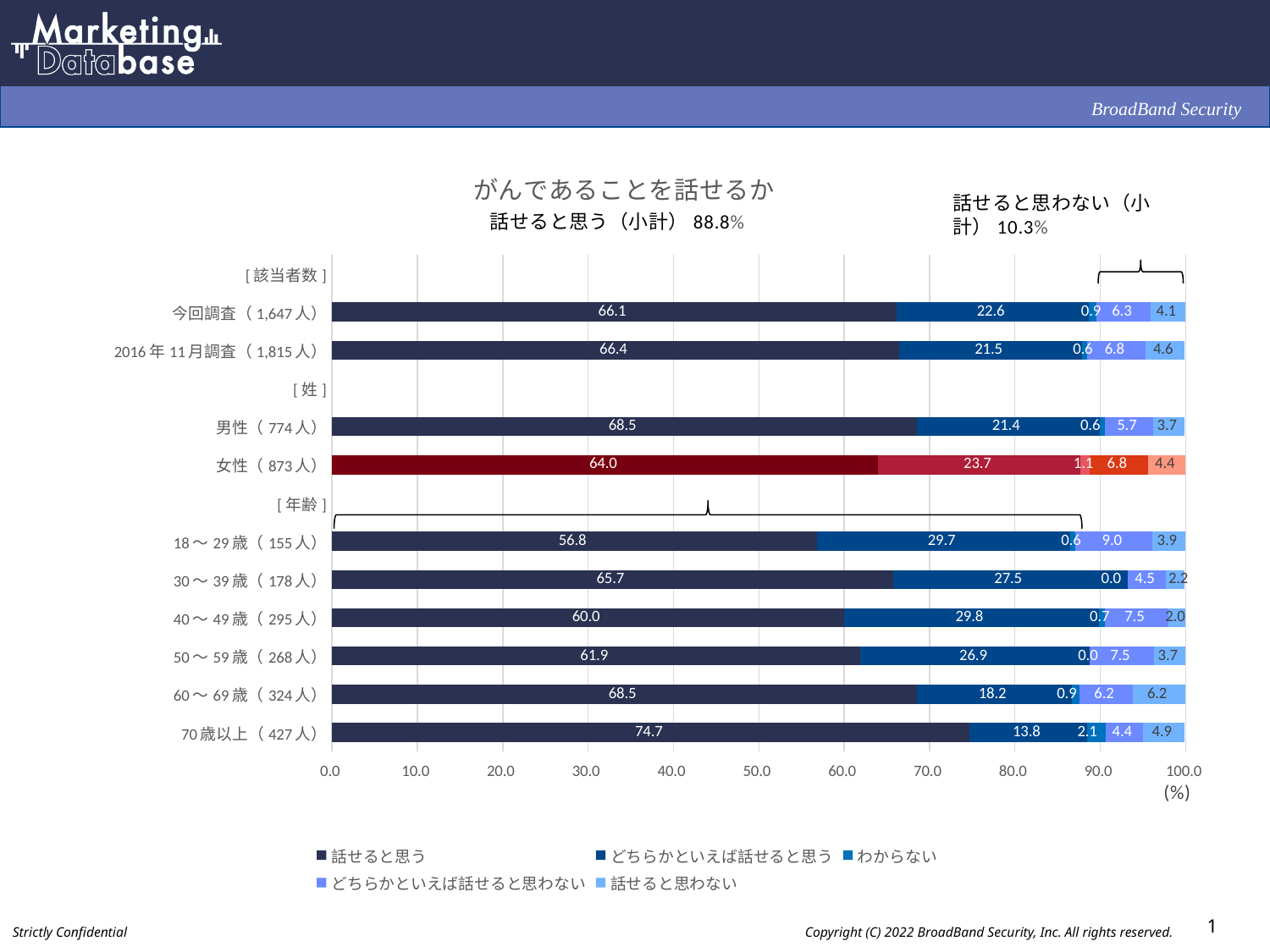
Which category has the lowest value for 話せると思う? 18〜29歳 (155人) What is the value of 話せると思う for 今回調査 (1,647人)? 66.1 Which is larger, the どちらかといえば話せると思う value for 18〜29歳 (155人) or for 70歳以上 (427人)? 18〜29歳 (155人) How many series does the legend list? 5 What is the 話せると思う (小計) percentage shown above the chart? 88.8% What type of chart is shown on the slide? Stacked bar chart What is the title of the chart? がんであることを話せるか What is the difference between the 話せると思う values for 男性 (774人) and 女性 (873人)? 4.5 What is the value of どちらかといえば話せると思う for 女性 (873人)? 23.7 What is the value of わからない for 70歳以上 (427人)? 2.1 Which category has the highest value for 話せると思う? 70歳以上 (427人) What is the value of 話せると思わない for 60〜69歳 (324人)? 6.2